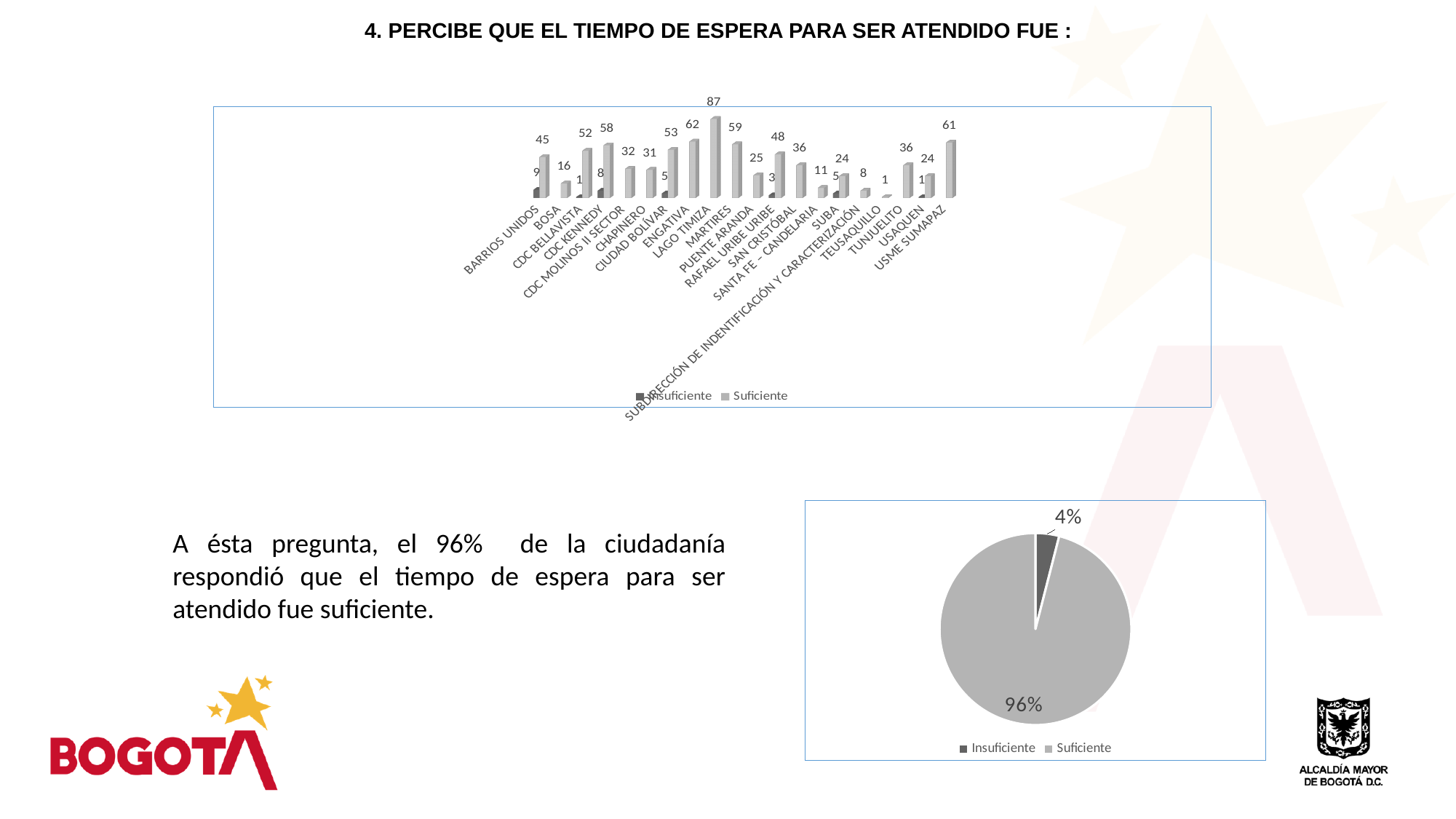
In the top bar chart, what are the two legend entries? Insuficiente and Suficiente In the top bar chart, what is the Suficiente value for USME SUMAPAZ? 61 In the bottom-right pie chart, what share of responses is Suficiente? 96% In the top bar chart, what is the Suficiente value for LAGO TIMIZA? 87 In the bottom-right pie chart, what share of responses is Insuficiente? 4% In the top bar chart, what is the Suficiente value for BARRIOS UNIDOS? 45 In the top bar chart, how many series does the legend list? 2 What kind of chart is the top chart on the slide? bar chart In the top bar chart, which has a larger Suficiente value, LAGO TIMIZA or ENGATIVA? LAGO TIMIZA What kind of chart is the bottom-right chart on the slide? pie chart In the top bar chart, how many categories are shown on the x axis? 20 In the top bar chart, which category has the highest Suficiente value? LAGO TIMIZA